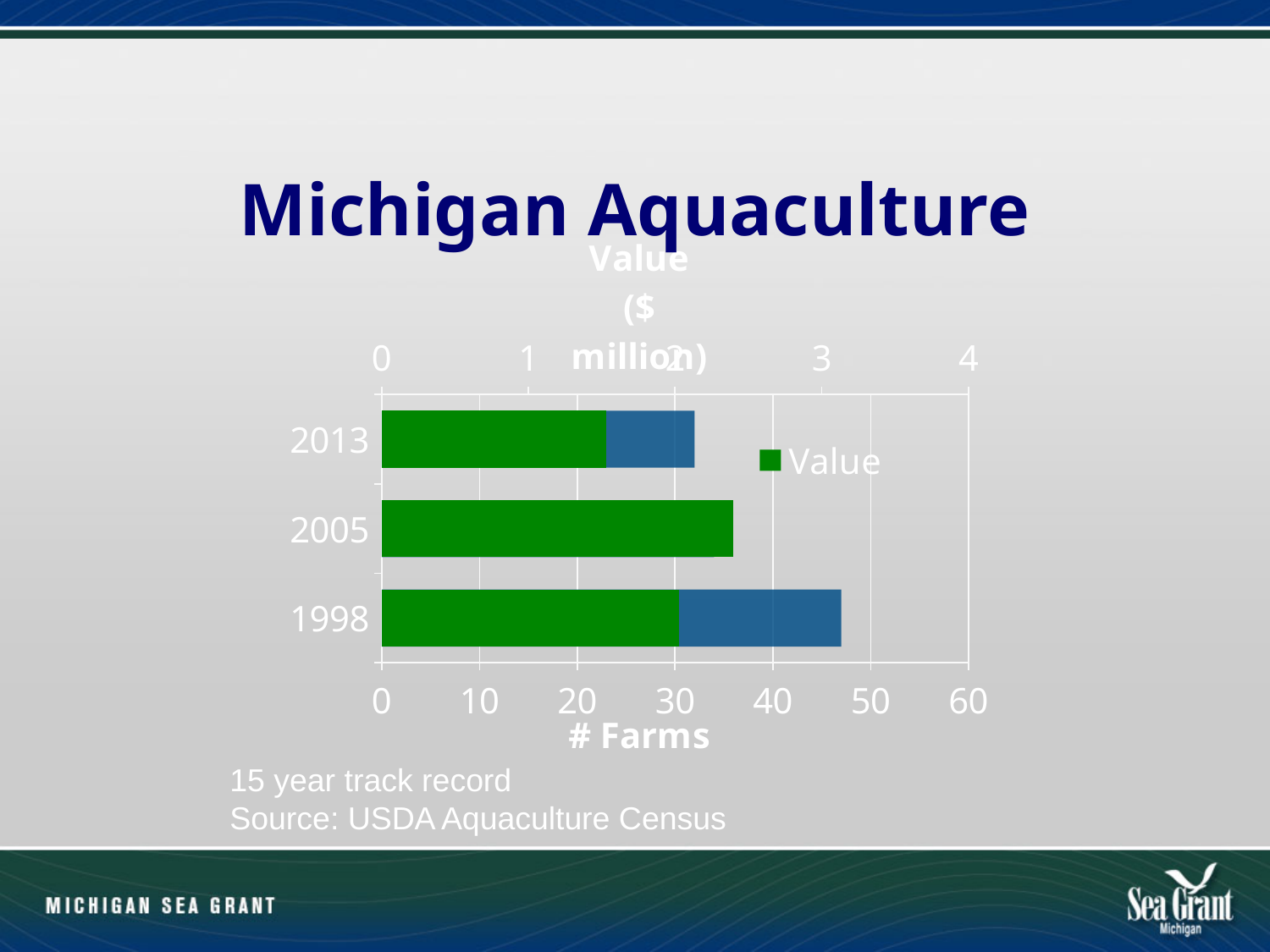
Which year has the longer blue bar, 1998 or 2013? 1998 Which year has the shortest green (Value) bar? 2013 How many years (categories) are shown on the chart? 3 What kind of chart is shown on the slide? bar chart Is the blue bar for 1998 greater or less than 40 on the # Farms axis? greater What is the title of the axis along the bottom of the chart? # Farms Which year has no blue bar shown? 2005 Which year has the longest green (Value) bar? 2005 Is the green (Value) bar for 2005 greater or less than 2 on the Value ($ million) axis? greater Is the green (Value) bar for 2013 greater or less than 2 on the Value ($ million) axis? less